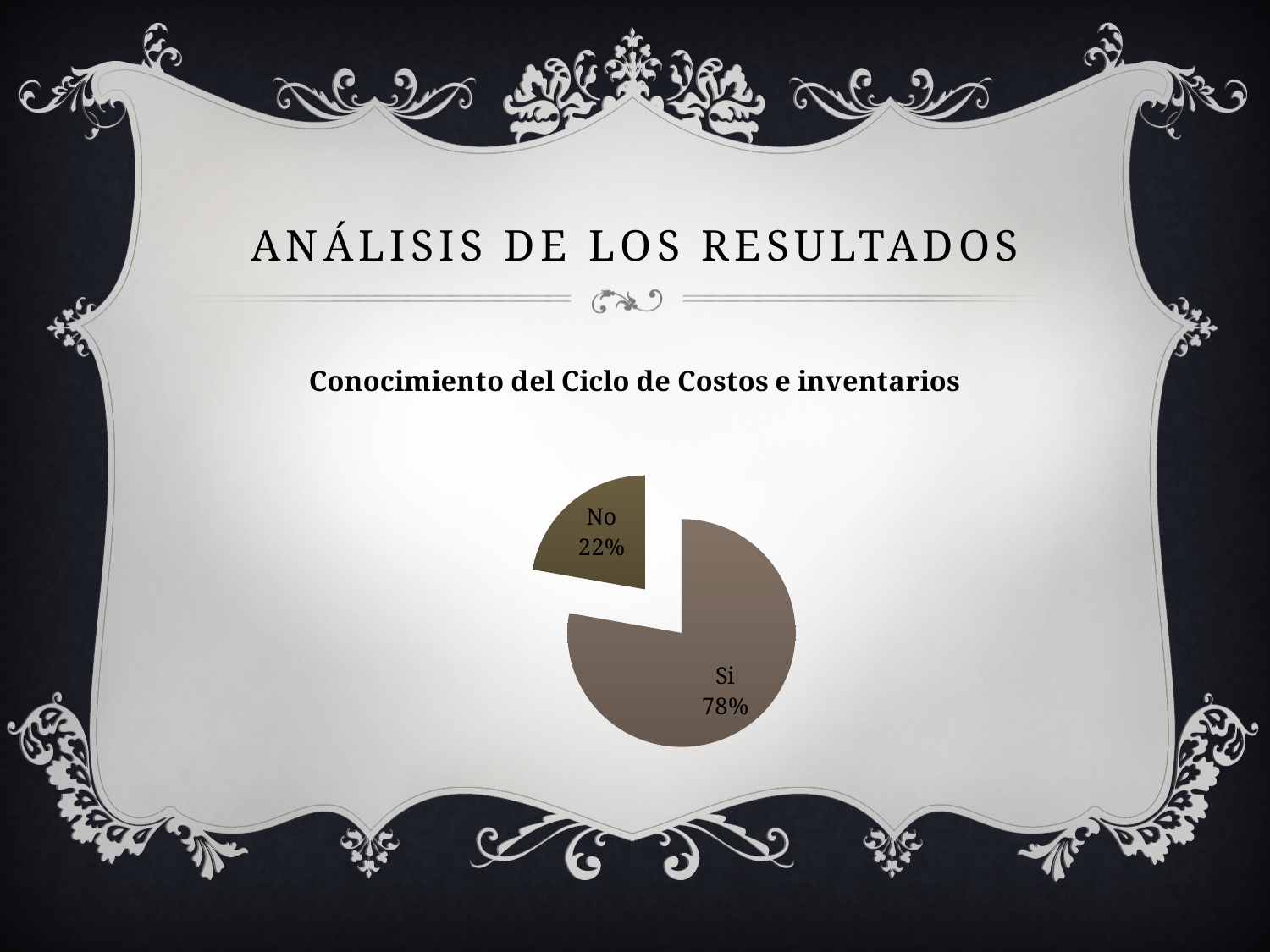
What type of chart is shown on the slide? pie chart What is the title of the chart? Conocimiento del Ciclo de Costos e inventarios Which is larger, the "Si" slice or the "No" slice? Si How many slices does the pie chart have? 2 Which slice of the pie is the largest? Si What is the difference in percentage points between the "Si" and "No" slices? 56 What share of the pie does the "No" slice represent? 22% What percentage of the pie is labelled "Si"? 78% Which slice is separated (exploded) from the rest of the pie? No What percentage of the pie is labelled "No"? 22% Which slice of the pie is the smallest? No Is the "Si" slice greater or less than 50% of the pie? greater